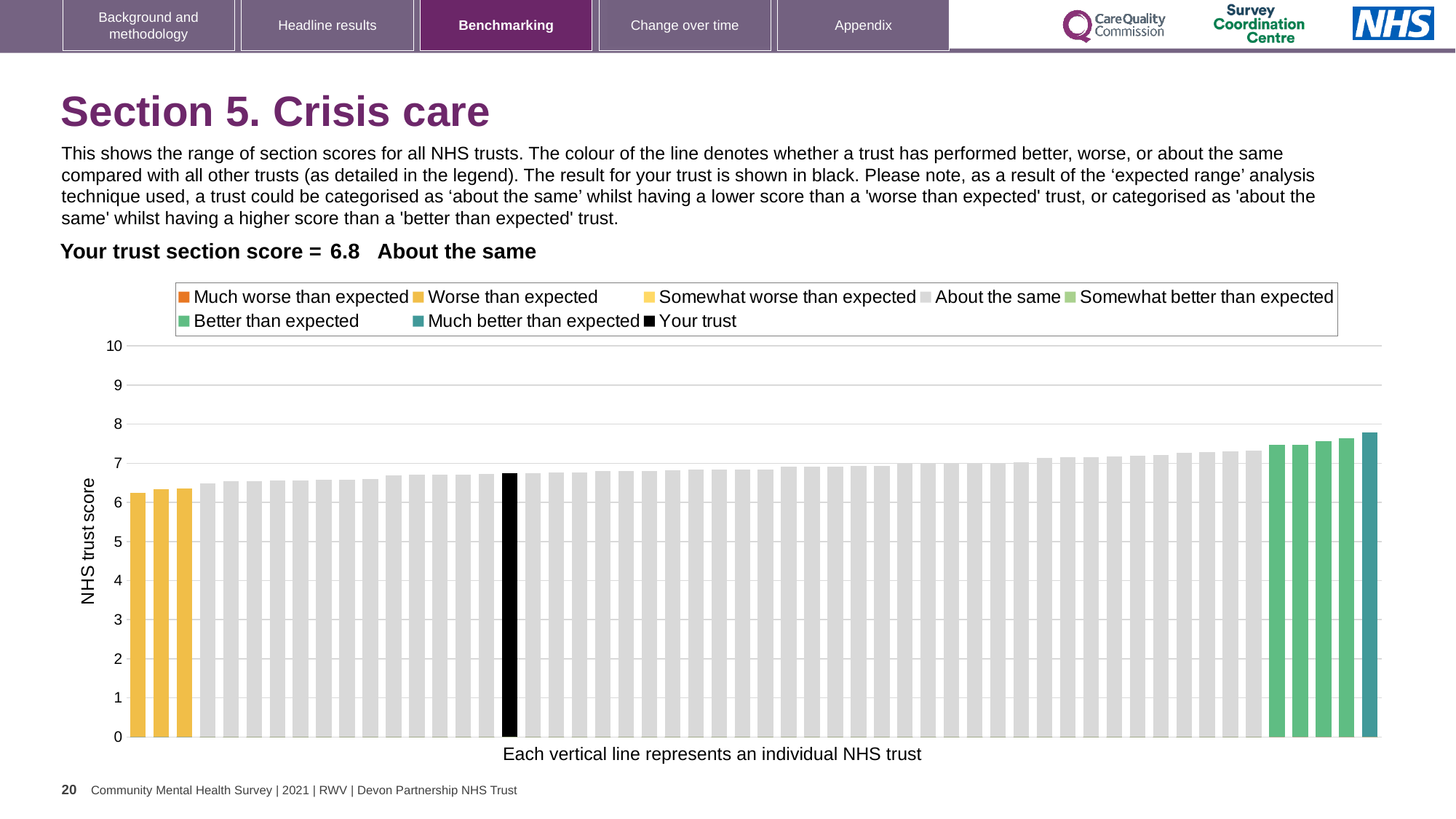
Is the value for your trust (the black bar) greater or less than 5? greater How many entries does the chart legend list? 8 How is your trust's section score categorised compared with other trusts? About the same What is the label on the vertical axis of the chart? NHS trust score Do the bar values rise or fall from left to right along the x axis? rise How many bars are coloured as 'Worse than expected' (yellow)? 3 Is the value of the tallest bar (the rightmost trust) greater or less than 7? greater Is the value of the shortest bar (the leftmost trust) greater or less than 7? less How many bars are coloured as 'Much better than expected' (teal)? 1 What is the highest value shown on the vertical axis? 10 What kind of chart is shown on the slide? bar chart What is the section score for your trust shown on the slide? 6.8